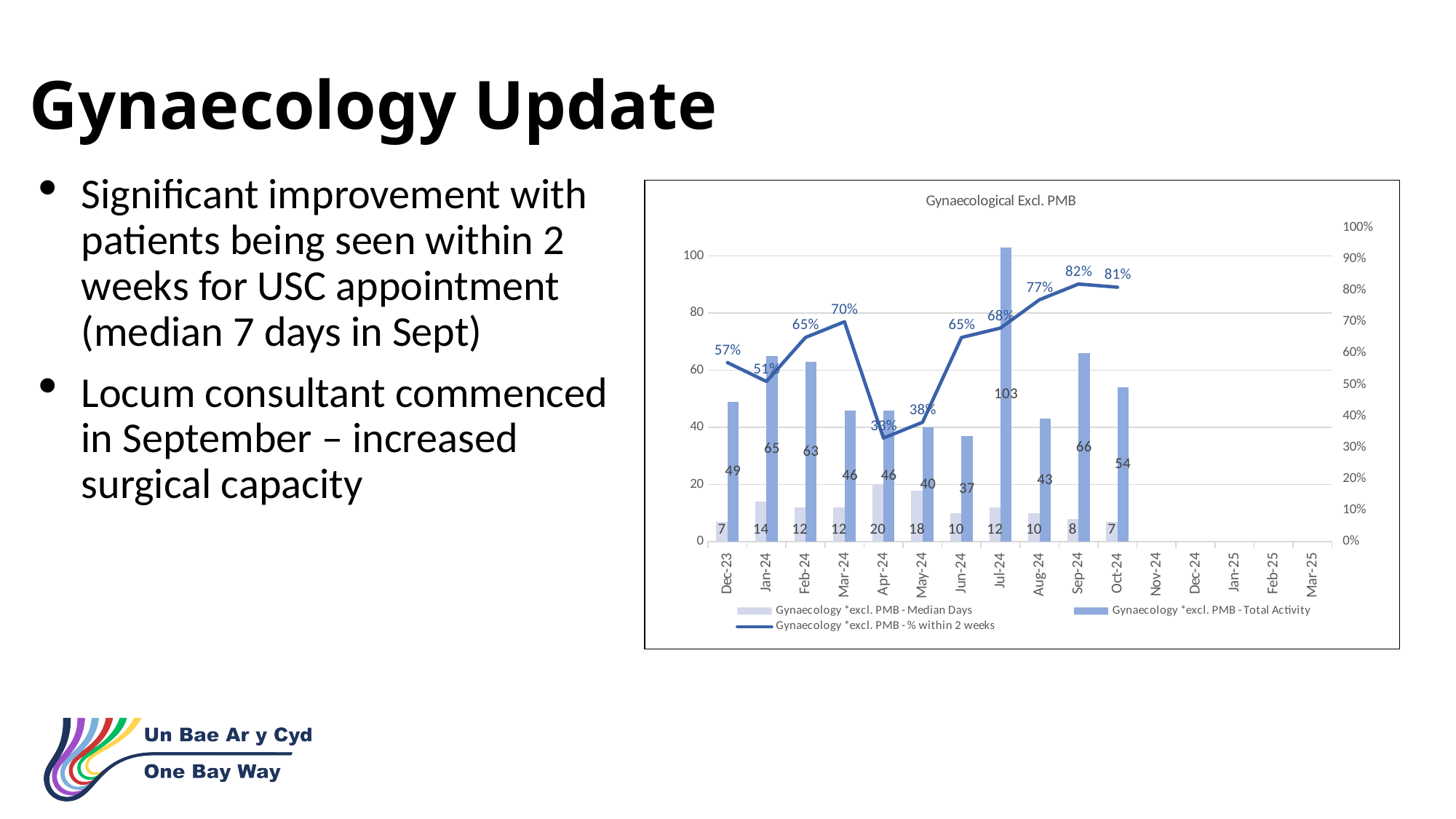
What percentage of patients were seen within 2 weeks in Sep-24? 82% Is the Total Activity for Jul-24 greater or less than 100? greater What is the Median Days value for Apr-24? 20 Which month has the highest Total Activity? Jul-24 How many series does the legend list? 3 Does the % within 2 weeks line rise or fall from Apr-24 to Sep-24? rise Which is larger, the Total Activity for Jan-24 or for Feb-24? Jan-24 What is the Median Days value for Oct-24? 7 What is the Total Activity value for Jul-24? 103 What is the difference in Total Activity between Sep-24 and Oct-24? 12 What is the title of the chart? Gynaecological Excl. PMB Which month has the lowest % within 2 weeks? Apr-24